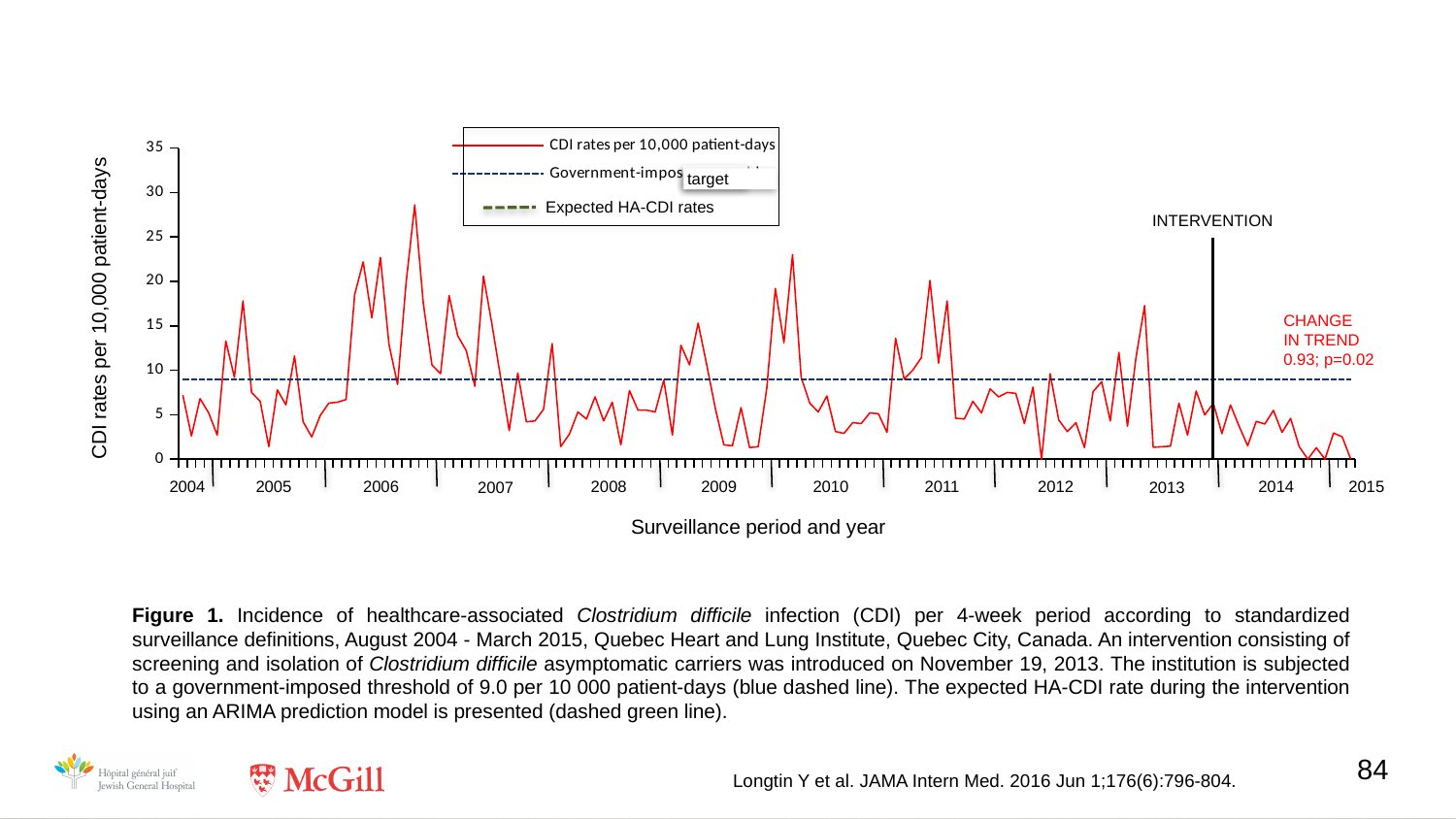
Are the CDI rates in 2014, after the intervention, greater or less than 10? less What kind of chart is shown on the slide? Line chart What change in trend value is annotated on the chart after the intervention? 0.93; p=0.02 In which year does the CDI rate reach its highest peak on the chart? 2006 Is the highest peak of the CDI rate in 2006 greater or less than 25? greater Is the peak CDI rate in 2009 greater or less than 20? greater What does the blue dashed line on the chart represent? Government-imposed target How many year labels are shown on the x axis of the chart? 12 What is the value of the government-imposed threshold shown as the blue dashed line? 9.0 per 10 000 patient-days Do the CDI rates generally rise or fall after the intervention line in late 2013? fall What is the title of the y axis of the chart? CDI rates per 10,000 patient-days How many series does the chart legend list? 3